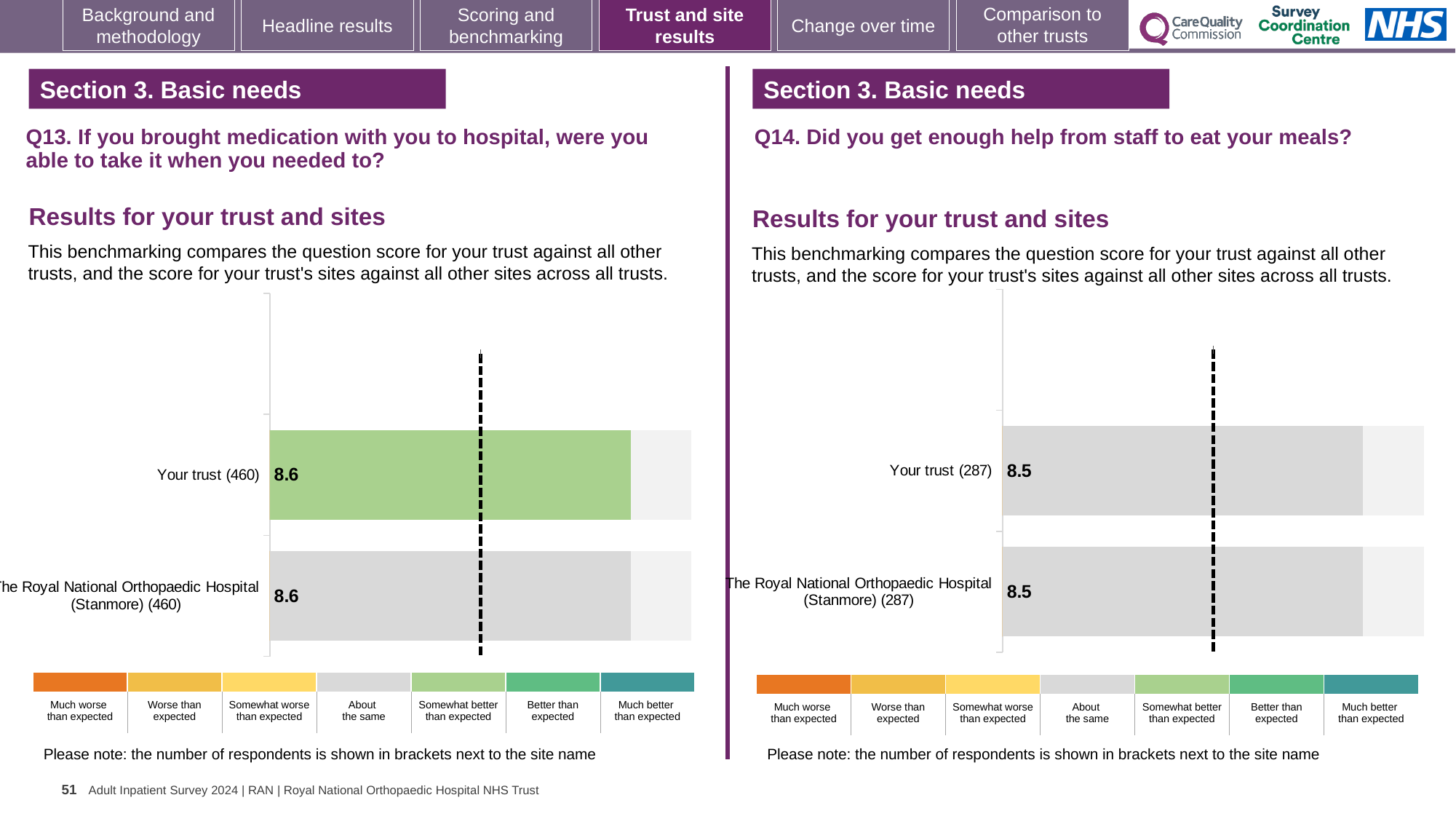
In the Q14 chart on the right, is the score for Your trust larger than, smaller than, or equal to the score for The Royal National Orthopaedic Hospital (Stanmore)? Equal In the Q14 chart on the right, how many respondents are shown in brackets next to The Royal National Orthopaedic Hospital (Stanmore)? 287 In the Q14 chart on the right, what is the difference between the score for Your trust and the score for The Royal National Orthopaedic Hospital (Stanmore)? 0 How many bars are plotted in the Q14 chart on the right? 2 In the Q14 chart on the right, what is the score for Your trust? 8.5 In the Q13 chart on the left, how many respondents are shown in brackets next to Your trust? 460 In the Q14 chart on the right, what is the score for The Royal National Orthopaedic Hospital (Stanmore)? 8.5 In the Q13 chart on the left, what is the score for Your trust? 8.6 In the Q13 chart on the left, what is the score for The Royal National Orthopaedic Hospital (Stanmore)? 8.6 In the Q13 chart on the left, what is the difference between the score for Your trust and the score for The Royal National Orthopaedic Hospital (Stanmore)? 0 What kind of chart is used for the Q13 results on the left? Bar chart How many bars are plotted in the Q13 chart on the left? 2